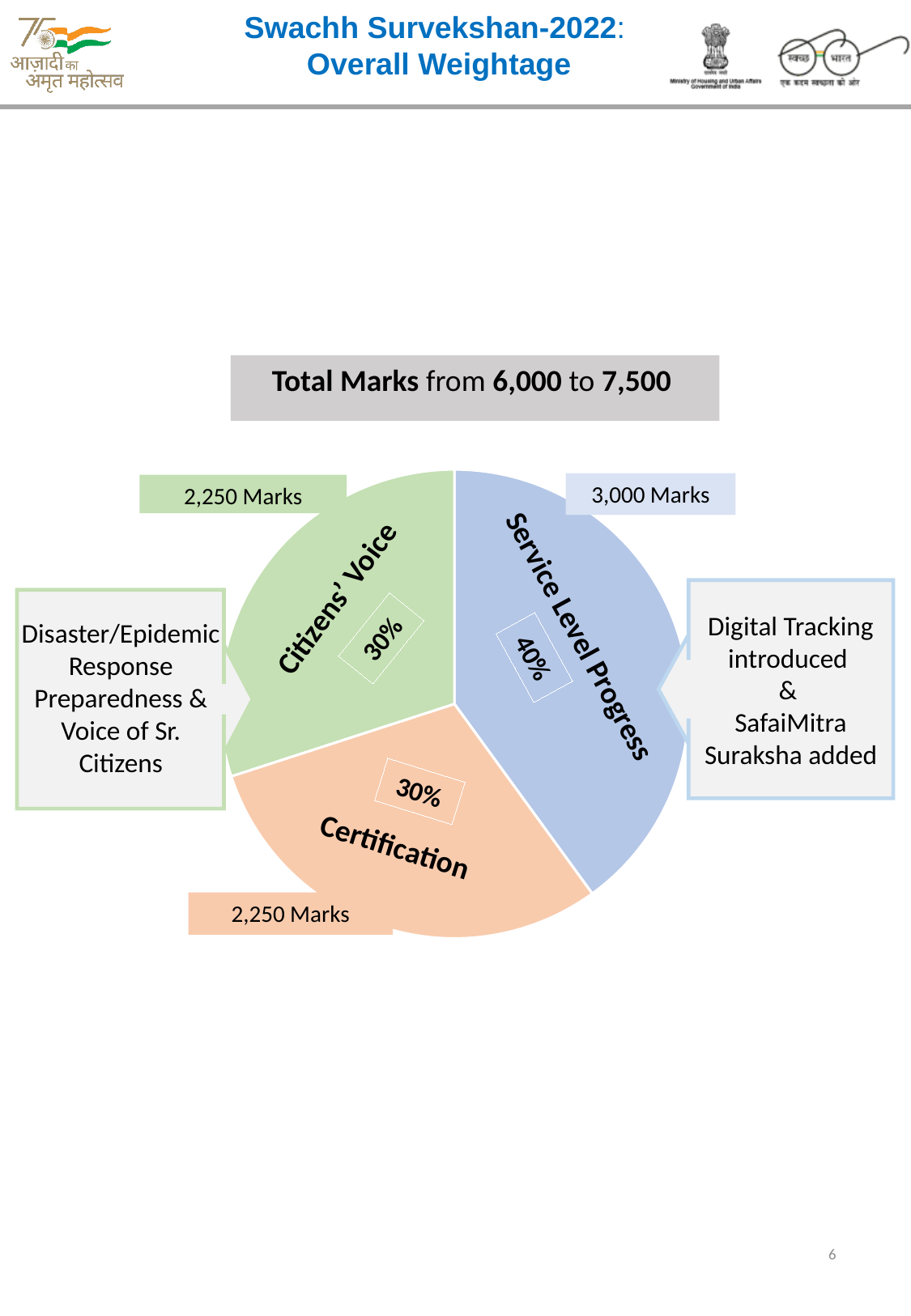
What colour is the Certification slice? Orange What percentage share does the Certification slice have? 30% What percentage share does the Service Level Progress slice have? 40% How many slices does the pie chart have? 3 How many marks are allotted to Certification? 2,250 Marks How many marks are allotted to Service Level Progress? 3,000 Marks What is the difference in marks between Service Level Progress and Certification? 750 Marks Which component has the largest share of the pie? Service Level Progress How many marks are allotted to Citizens' Voice? 2,250 Marks What percentage share does the Citizens' Voice slice have? 30% Which has a larger share, Service Level Progress or Citizens' Voice? Service Level Progress What kind of chart is shown on the slide? Pie chart